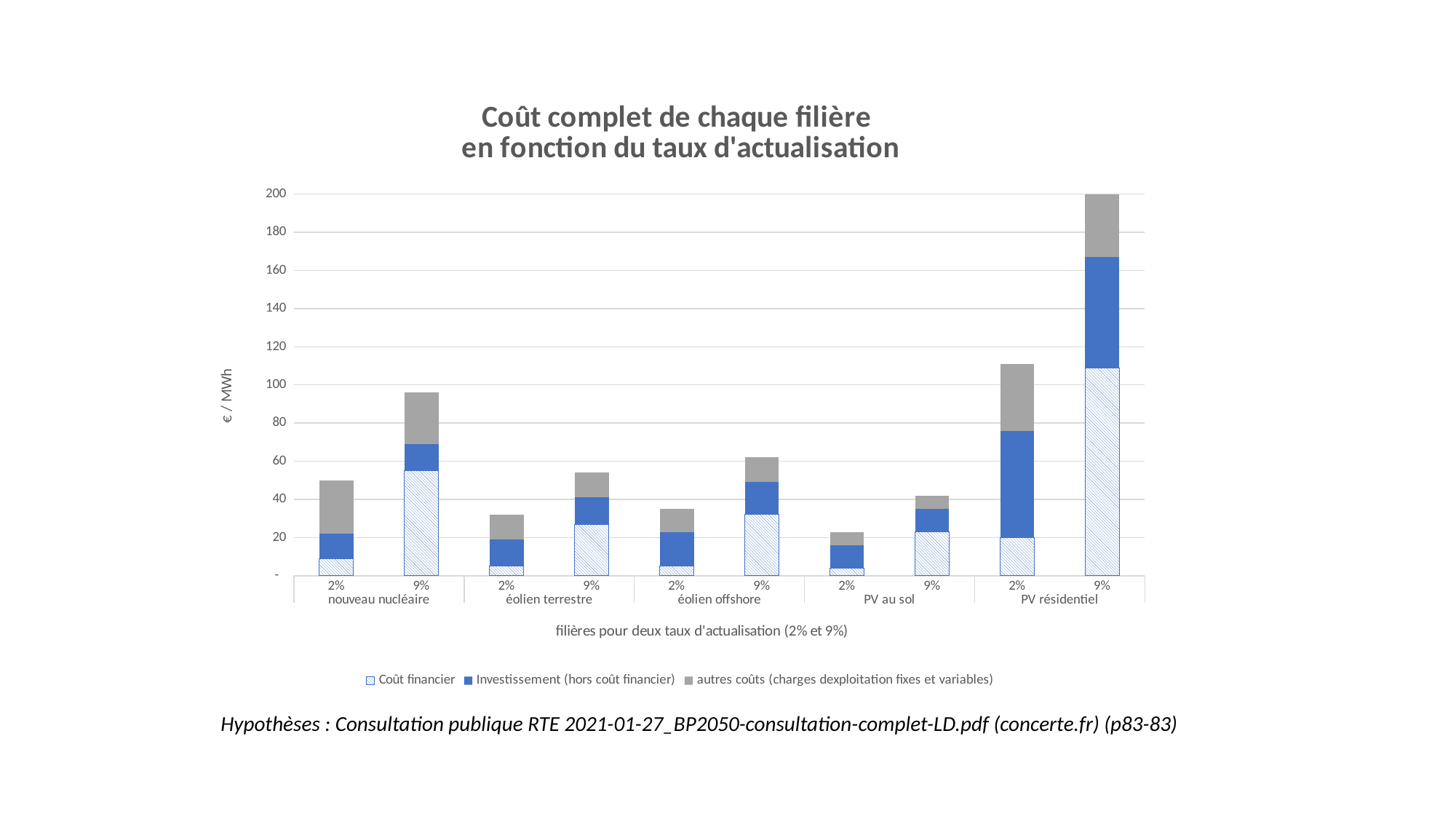
Which has the larger total cost: nouveau nucléaire at 9% or éolien offshore at 9%? nouveau nucléaire at 9% Which bar has the lowest total cost? PV au sol at 2% How many bars are plotted in the chart? 10 What kind of chart is shown on the slide? stacked bar chart Is the total value for PV résidentiel at 9% greater or less than 180? greater Is the total value for nouveau nucléaire at 9% greater or less than 100? less How many filières (technology categories) are shown on the x axis? 5 Is the total value for PV résidentiel at 2% greater or less than 100? greater How many series does the legend list? 3 Which bar has the highest total cost? PV résidentiel at 9% What is the label of the vertical axis? € / MWh